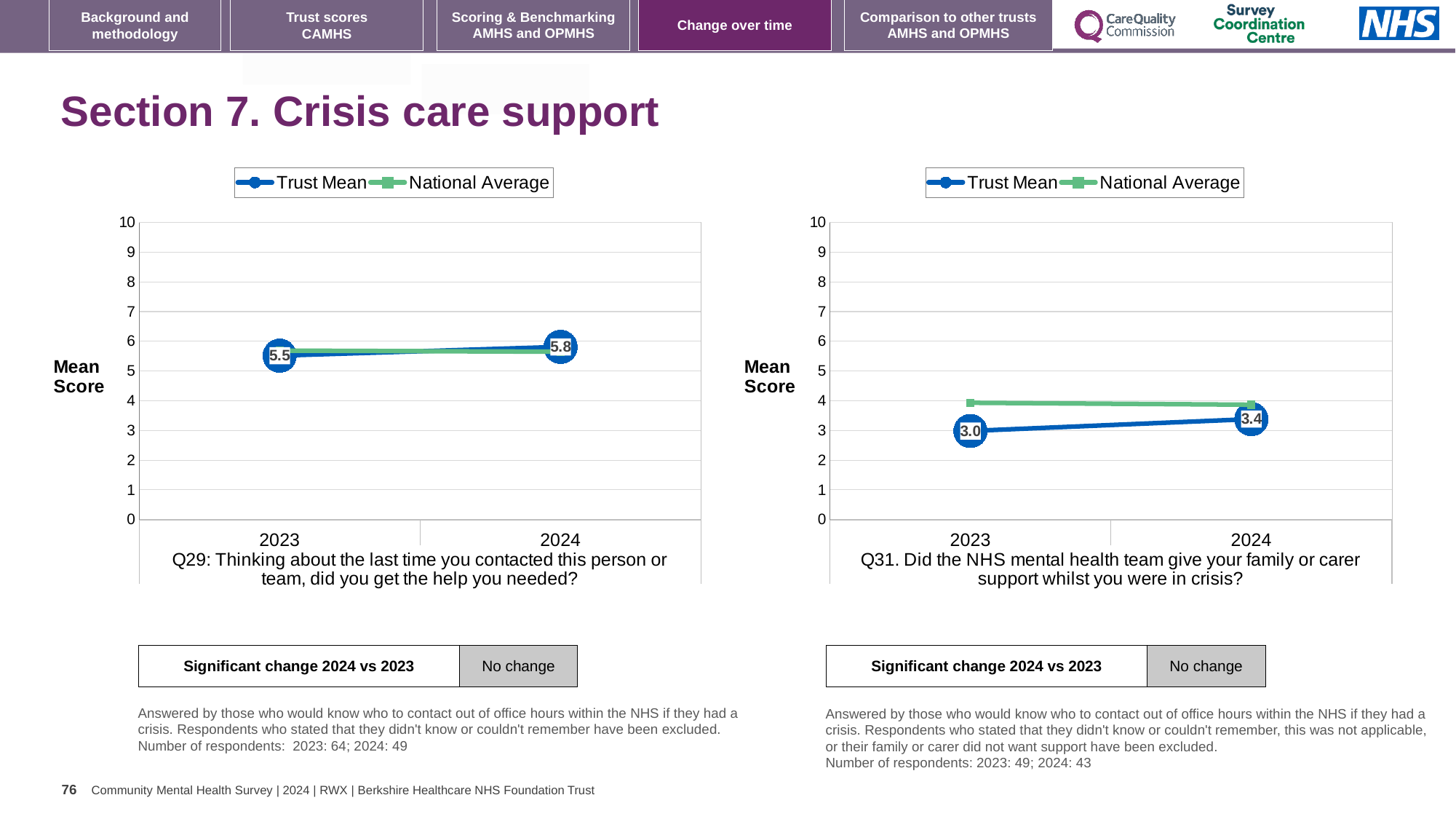
In the Q29 chart on the left, what is the Trust Mean for 2023? 5.5 What kind of chart is the Q29 chart on the left? line chart In the Q31 chart on the right, which is higher in 2023: the Trust Mean or the National Average? National Average In the Q29 chart on the left, what is the Trust Mean for 2024? 5.8 In the Q29 chart on the left, by how much did the Trust Mean change from 2023 to 2024? 0.3 In the Q31 chart on the right, is the National Average for 2023 greater or less than 3? greater How many years are plotted on the x axis of the Q29 chart on the left? 2 How many series does the legend of the Q31 chart on the right list? 2 In the Q31 chart on the right, does the Trust Mean rise or fall from 2023 to 2024? rise In the Q31 chart on the right, what is the Trust Mean for 2023? 3.0 In the Q31 chart on the right, by how much did the Trust Mean change from 2023 to 2024? 0.4 In the Q31 chart on the right, what is the Trust Mean for 2024? 3.4